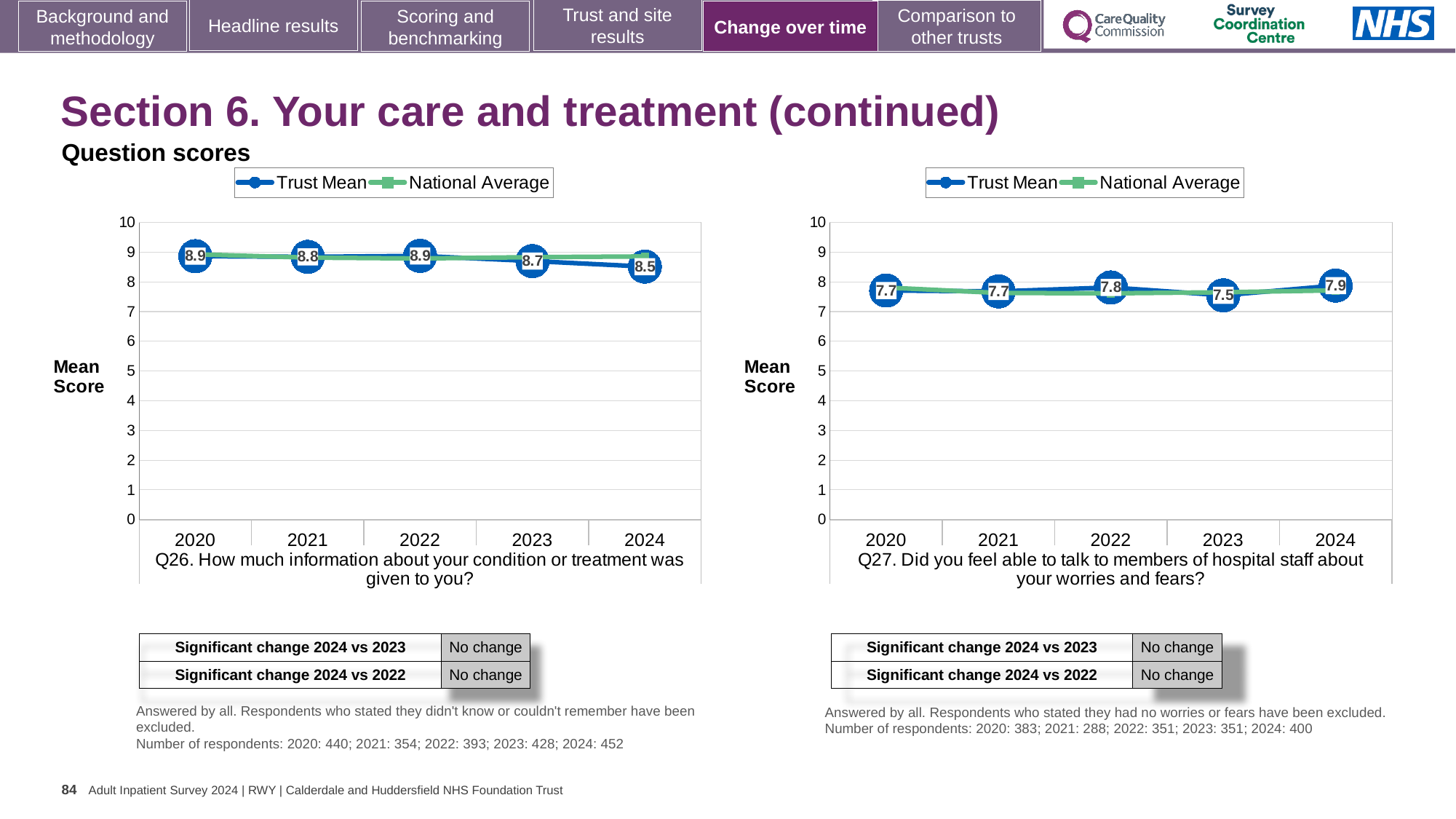
On the Q27 chart (right), what is the Trust Mean score for 2023? 7.5 On the Q27 chart (right), what is the difference between the Trust Mean scores for 2024 and 2023? 0.4 How many years are plotted on the Q27 chart (right)? 5 On the Q26 chart (left), what is the Trust Mean score for 2024? 8.5 How many series does the legend of the Q26 chart (left) list? 2 On the Q27 chart (right), is the Trust Mean score higher in 2022 or in 2023? 2022 On the Q27 chart (right), which year has the highest Trust Mean score? 2024 On the Q26 chart (left), does the Trust Mean score rise or fall from 2022 to 2024? Fall What type of chart is used for the Q26 chart (left)? Line chart On the Q26 chart (left), what is the difference between the Trust Mean scores for 2020 and 2024? 0.4 On the Q26 chart (left), is the Trust Mean value for 2023 greater or less than 8? greater On the Q26 chart (left), which year has the lowest Trust Mean score? 2024